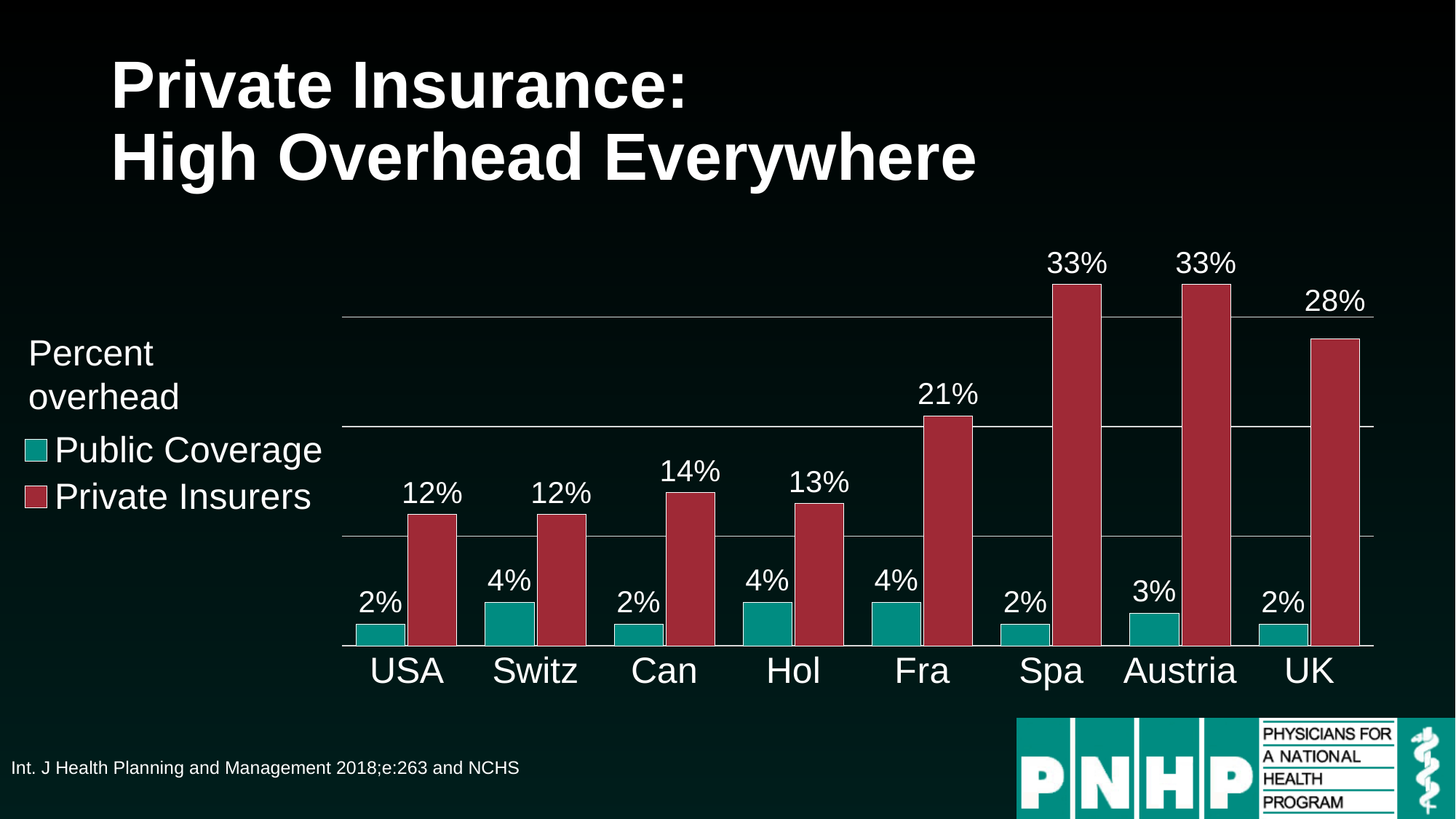
How many series does the legend list? 2 What is the Public Coverage overhead value for Switz? 4% What kind of chart is shown on the slide? Bar chart Which is larger, the Private Insurers overhead for Hol or for Fra? Fra Which legend entry is shown in red? Private Insurers What is the Private Insurers overhead value for the USA? 12% Which country has the lowest Private Insurers overhead? USA and Switz (12%) How many countries are shown on the x axis? 8 What is the Public Coverage overhead value for Austria? 3% What is the Private Insurers overhead value for Fra? 21% What is the difference between the Private Insurers and Public Coverage overhead for Spa? 31% What is the difference between the Private Insurers overhead for the UK and for Can? 14%